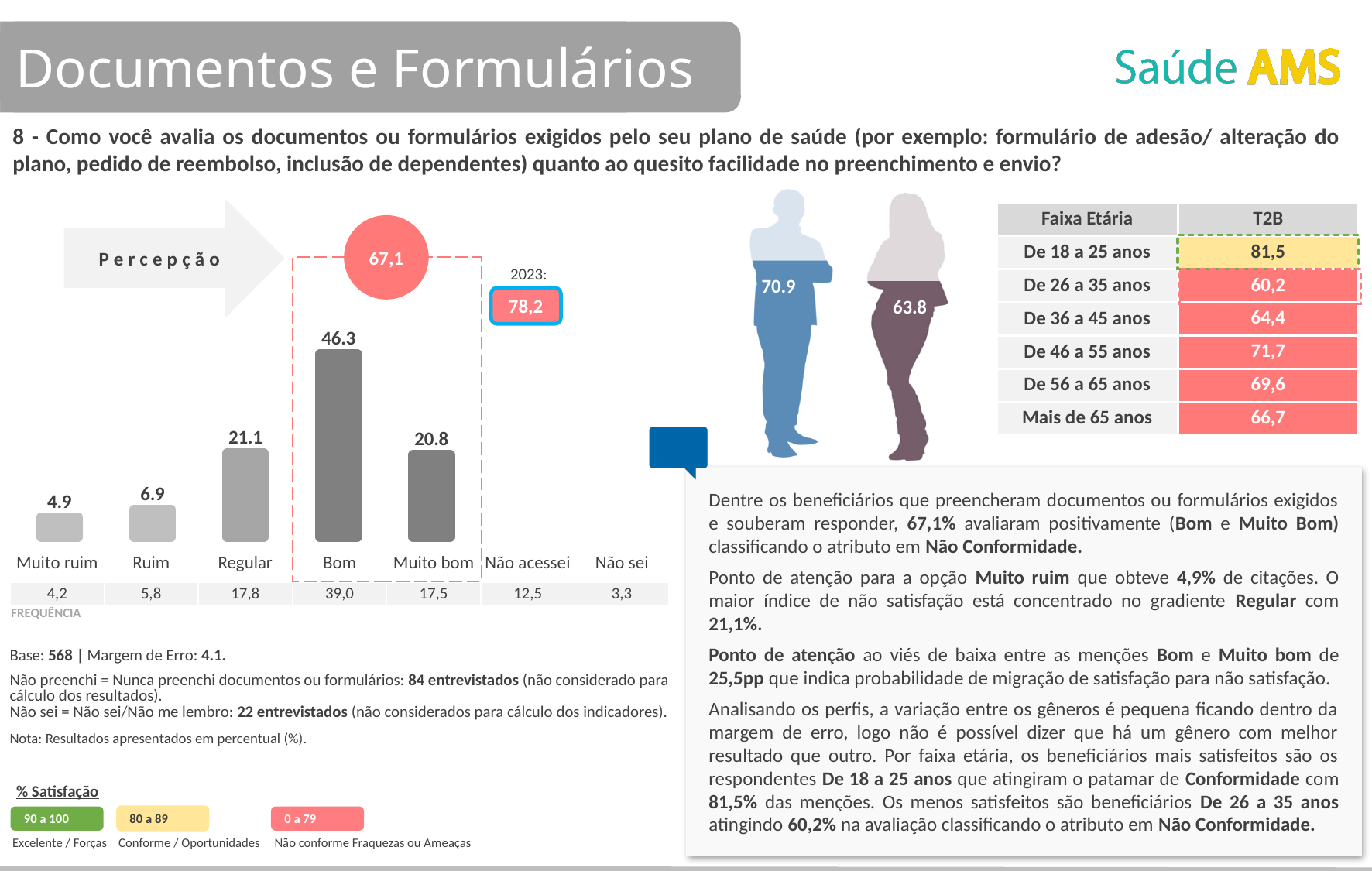
What is the value shown for the Bom bar in the bar chart? 46.3 Which category has the highest bar in the bar chart? Bom How many bars are plotted in the bar chart? 5 What kind of chart is used to show the Muito ruim to Muito bom ratings? Bar chart What is the value shown for the Muito bom bar in the bar chart? 20.8 What is the value shown for the Regular bar in the bar chart? 21.1 Which is larger in the bar chart, the value for Regular or the value for Muito bom? Regular What value is shown in the red circle above the Bom and Muito bom bars? 67,1 What is the difference between the Bom and Muito bom values in the bar chart? 25.5 What is the value shown for the Muito ruim bar in the bar chart? 4.9 What is the difference between the Ruim and Muito ruim values in the bar chart? 2.0 Which category has the lowest bar in the bar chart? Muito ruim